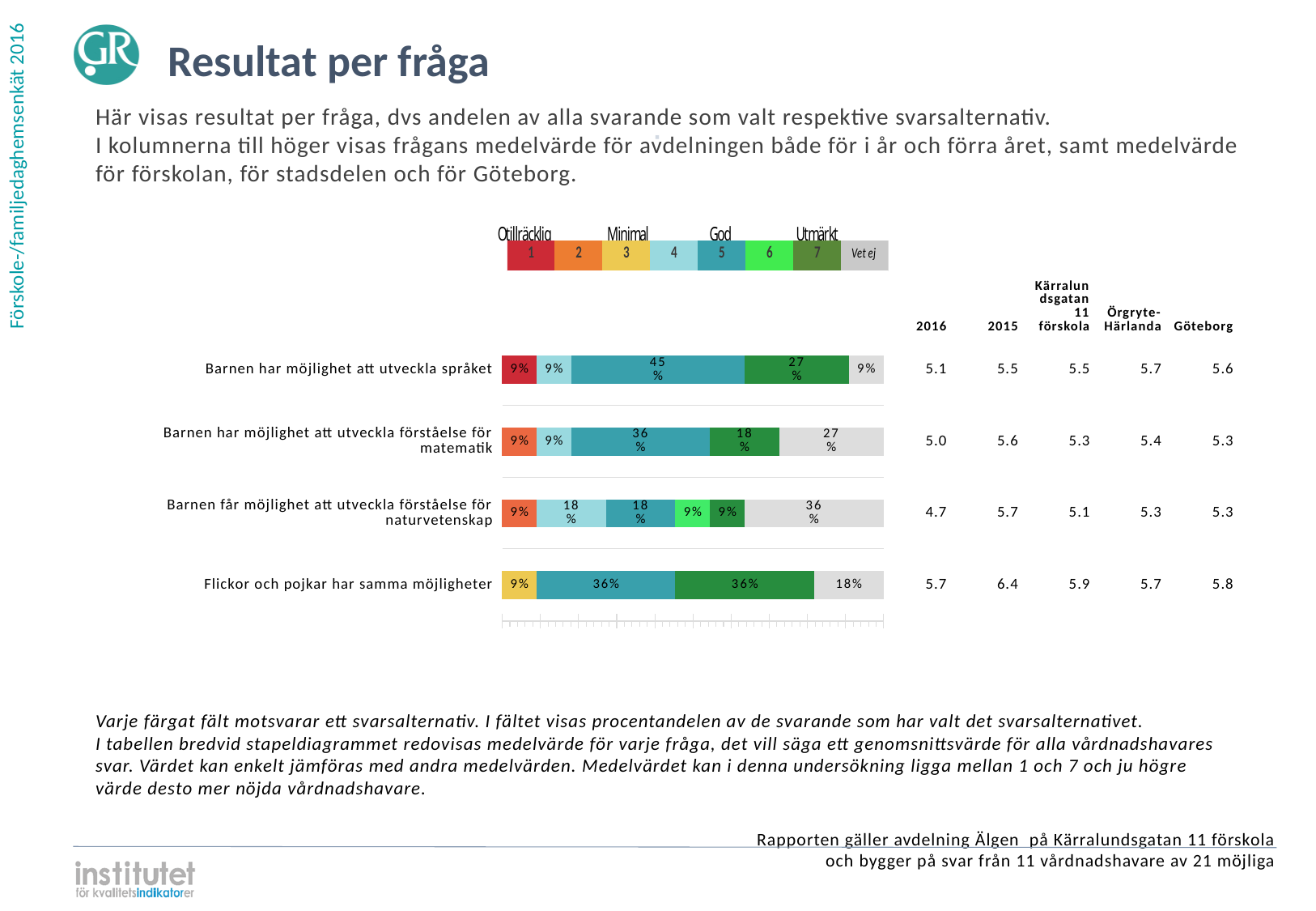
How many questions (categories) are plotted in the bar chart? 4 What is the 'Vet ej' (grey) share for 'Barnen får möjlighet att utveckla förståelse för naturvetenskap'? 36% What kind of chart is shown on the slide? Stacked bar chart Which segment is the largest in the bar for 'Barnen har möjlighet att utveckla språket'? 45% (teal, 5) What is the difference between the teal (5) segment for 'Barnen har möjlighet att utveckla språket' and the teal (5) segment for 'Barnen har möjlighet att utveckla förståelse för matematik'? 9% What percentage of respondents chose the teal (5) alternative for 'Barnen har möjlighet att utveckla språket'? 45% What is the grey 'Vet ej' share for 'Barnen har möjlighet att utveckla förståelse för matematik'? 27% Which bar has the largest 'Vet ej' (grey) share? Barnen får möjlighet att utveckla förståelse för naturvetenskap What is the label of the grey legend entry at the right end of the colour scale? Vet ej Is the dark green (7) segment larger for 'Barnen har möjlighet att utveckla språket' or for 'Barnen har möjlighet att utveckla förståelse för matematik'? Barnen har möjlighet att utveckla språket What percentage is shown for the dark green (7) segment of 'Flickor och pojkar har samma möjligheter'? 36% How many response alternatives does the legend above the chart list? 8